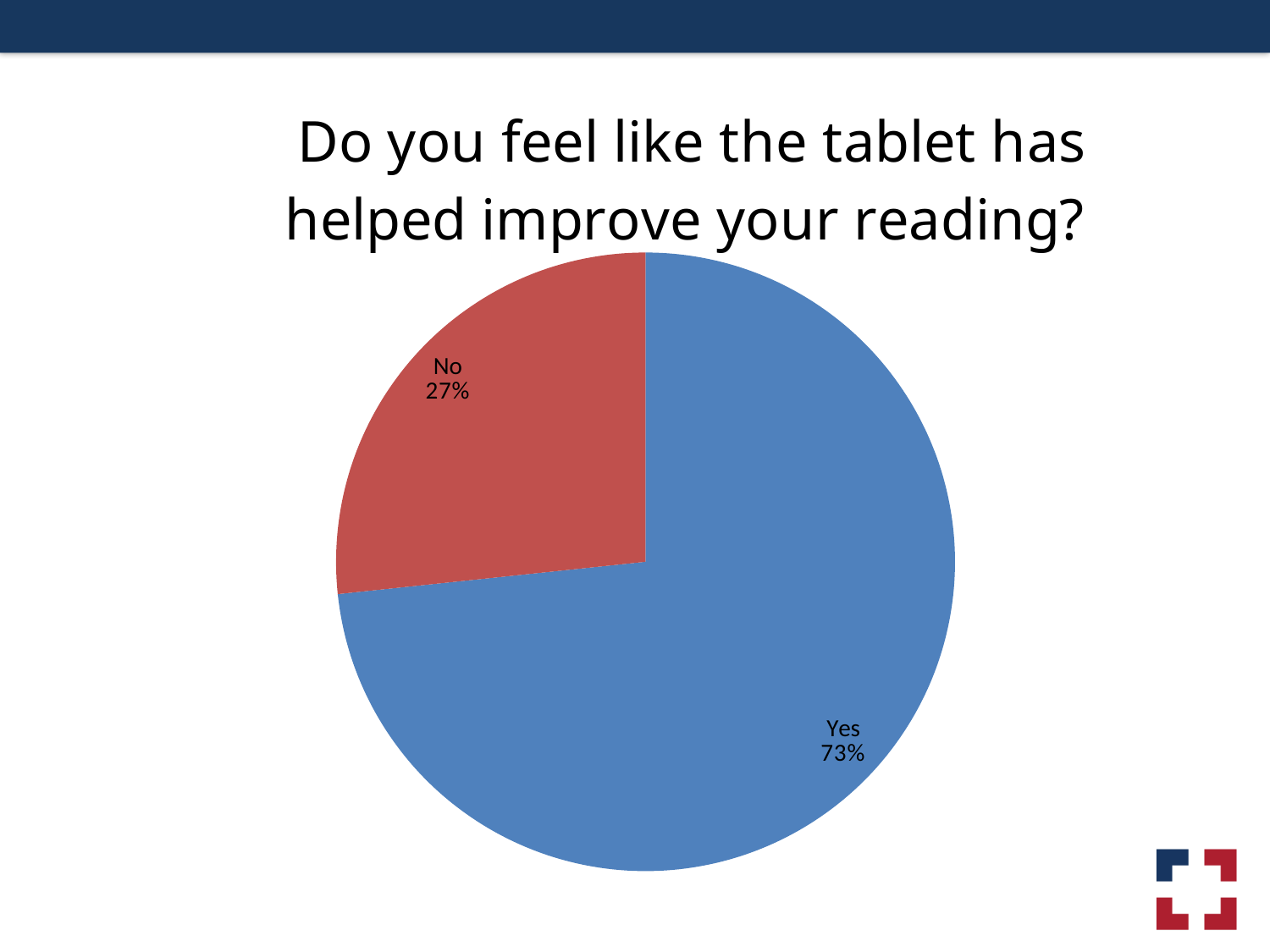
How many percentage points larger is the Yes share than the No share? 46 What is the title of the chart? Do you feel like the tablet has helped improve your reading? What share of the pie does the No slice represent? 27% Which response has the largest share of the pie? Yes What colour is the Yes slice? blue What percentage of respondents answered No? 27% What percentage of respondents answered Yes? 73% What kind of chart is shown on the slide? pie chart Which is larger, the Yes share or the No share? Yes Which response has the smallest share of the pie? No How many slices does the pie chart have? 2